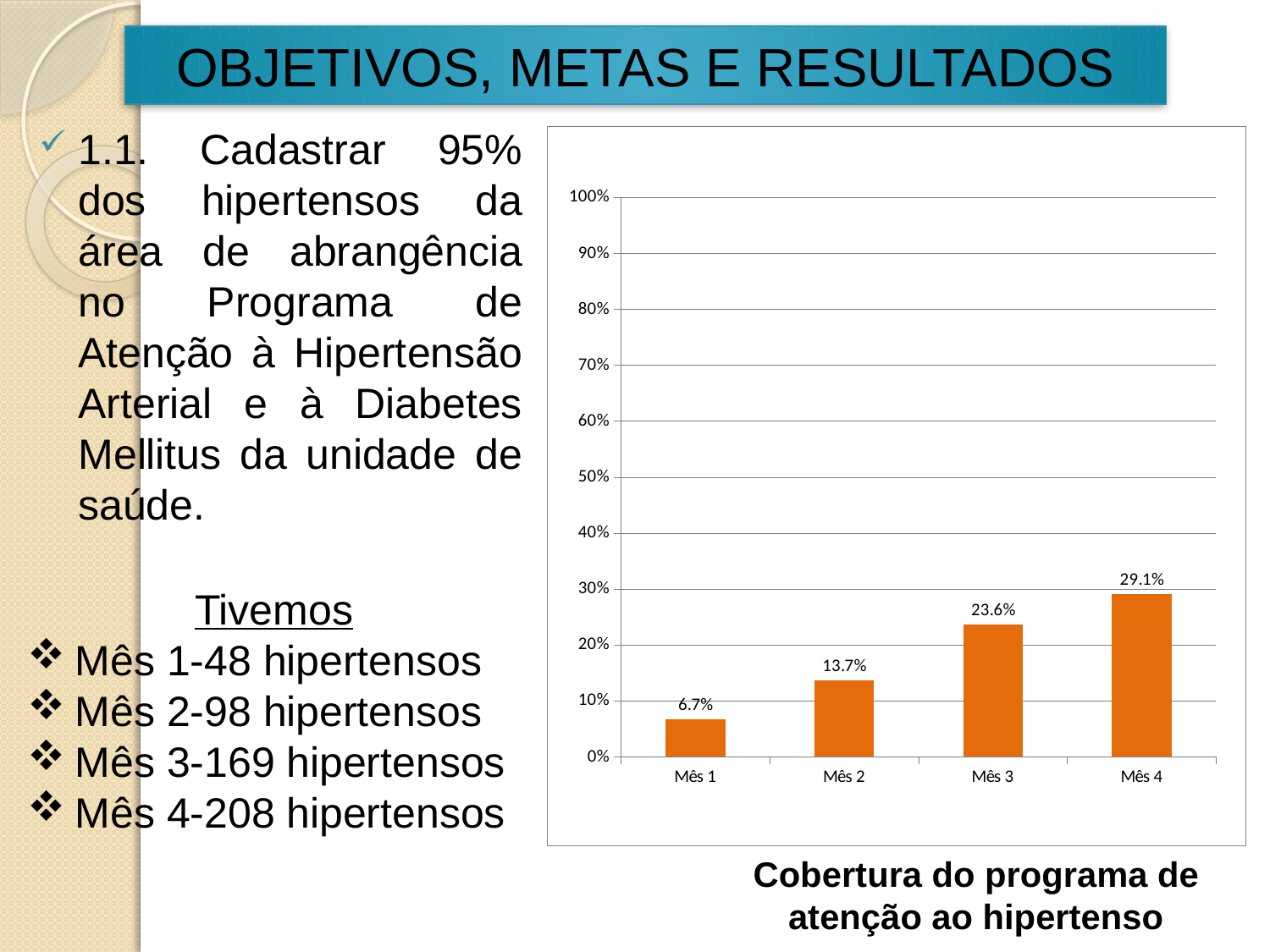
Which is larger, the value for Mês 2 or the value for Mês 3? Mês 3 Which month has the lowest value? Mês 1 What is the value for Mês 4? 29.1% Is the value for Mês 4 greater or less than 40%? less What is the difference between the values for Mês 3 and Mês 2? 9.9% What kind of chart is shown? bar chart What is the difference between the values for Mês 4 and Mês 1? 22.4% Which month has the highest value? Mês 4 What is the value for Mês 3? 23.6% Do the values rise or fall from Mês 1 to Mês 4? rise How many months are shown on the x axis? 4 What is the value for Mês 1? 6.7%